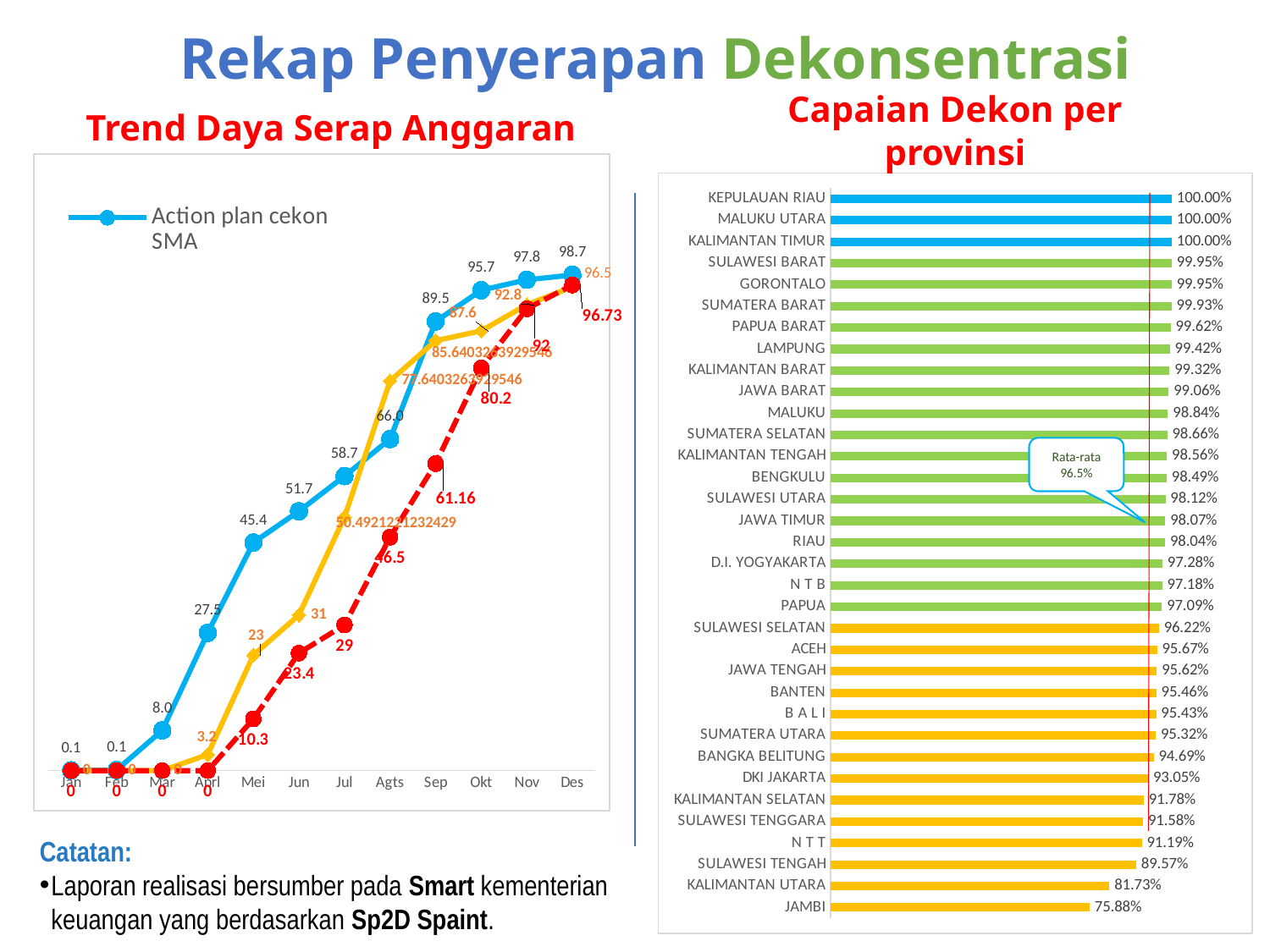
How many months are shown on the x axis of the 'Trend Daya Serap Anggaran' chart? 12 In the 'Capaian Dekon per provinsi' chart, what is the value for DKI JAKARTA? 93.05% In the 'Capaian Dekon per provinsi' chart, which is larger, SULAWESI TENGAH or N T T? N T T In the 'Capaian Dekon per provinsi' chart, which province has the lowest value? JAMBI In the 'Trend Daya Serap Anggaran' chart, does the 'Action plan cekon SMA' series rise or fall from Jan to Des? Rise What type of chart is 'Capaian Dekon per provinsi'? Bar chart In the 'Capaian Dekon per provinsi' chart, what is the value for JAMBI? 75.88% In the 'Capaian Dekon per provinsi' chart, what is the difference between KALIMANTAN UTARA and JAMBI? 5.85% In the 'Trend Daya Serap Anggaran' chart, what is the value of 'Action plan cekon SMA' in Sep? 89.5 In the 'Trend Daya Serap Anggaran' chart, what is the value of 'Action plan cekon SMA' in Des? 98.7 In the 'Capaian Dekon per provinsi' chart, what average (Rata-rata) value is shown in the callout? 96.5% How many provinces are shown in the 'Capaian Dekon per provinsi' chart? 34